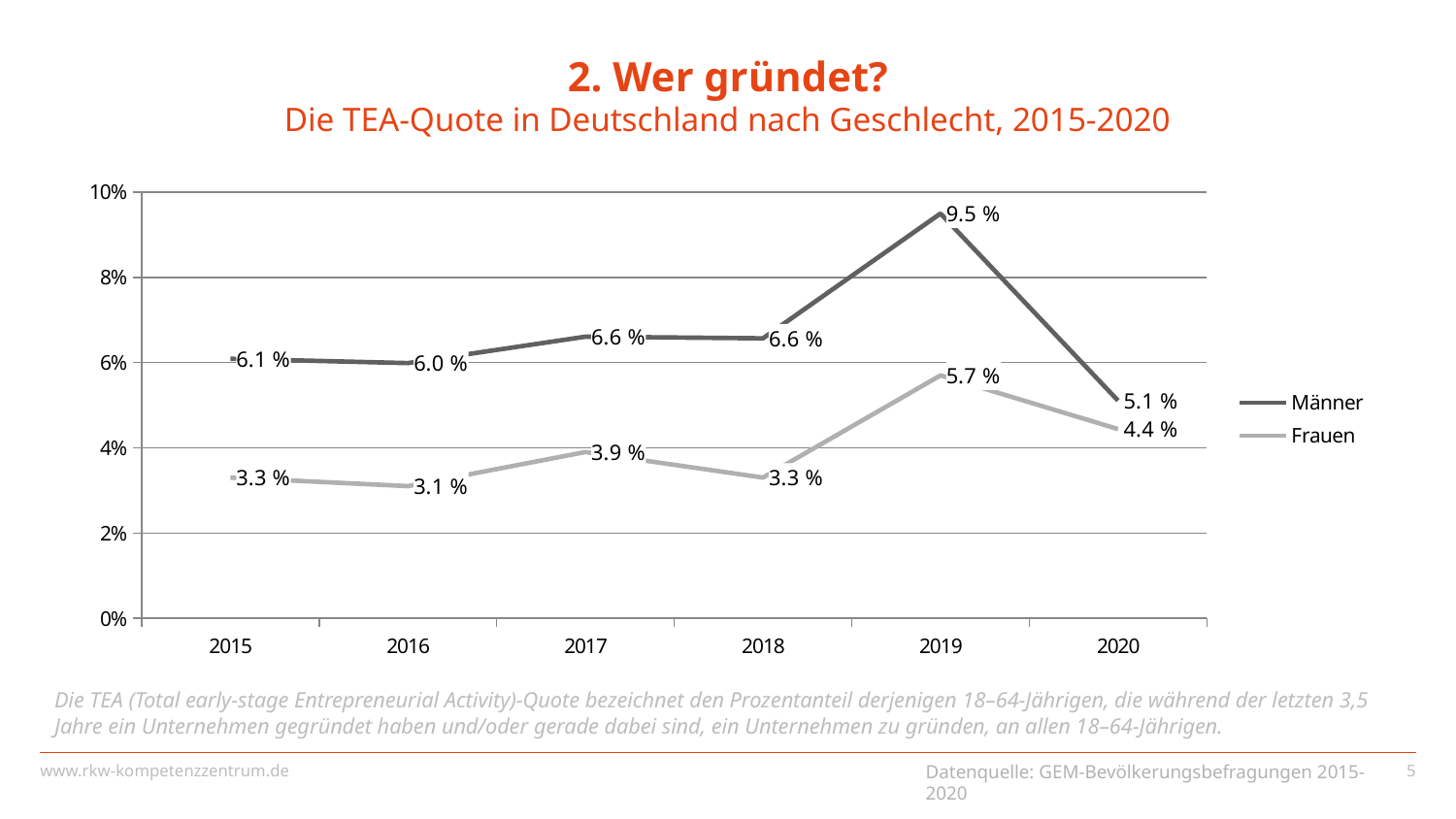
What is the TEA rate for Frauen in 2016? 3.1 % How many years are shown on the x axis? 6 Does the Männer TEA rate rise or fall from 2019 to 2020? fall What is the difference between the Männer and Frauen TEA rates in 2019? 3.8 % What kind of chart is shown on the slide? line chart Which is larger, the Männer TEA rate in 2020 or the Frauen TEA rate in 2019? Frauen TEA rate in 2019 What is the TEA rate for Männer in 2019? 9.5 % How many series does the legend list? 2 What is the TEA rate for Frauen in 2020? 4.4 % In which year is the TEA rate for Frauen lowest? 2016 Is the Männer TEA rate in 2018 greater or less than 8%? less In which year is the TEA rate for Männer highest? 2019